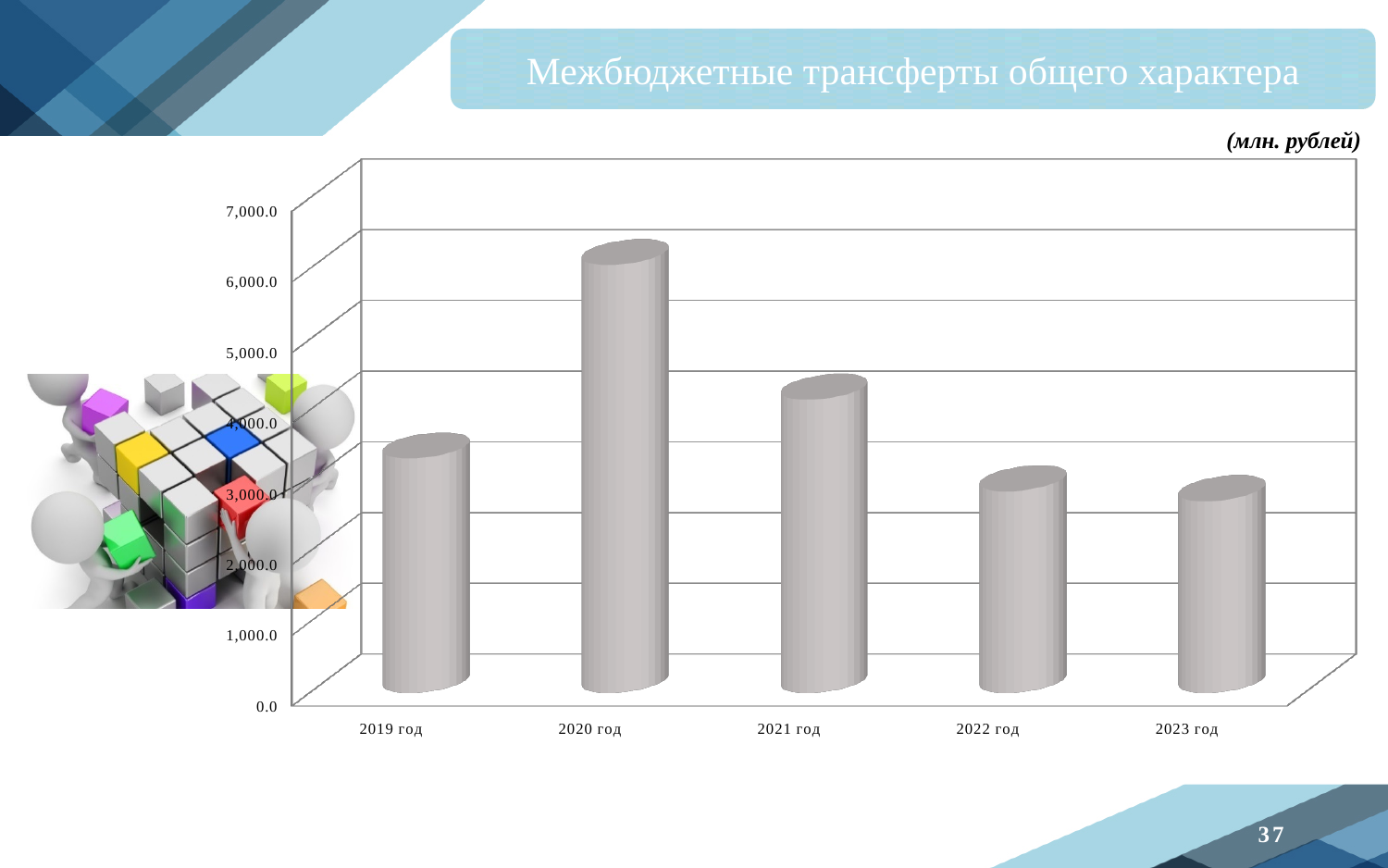
Which is larger, the value for 2020 год or the value for 2021 год? 2020 год Is the value for 2020 год greater or less than 5,000.0? greater Do the values rise or fall from 2020 год to 2023 год? fall Is the value for 2022 год greater or less than 4,000.0? less What kind of chart is shown on the slide? bar chart Is the value for 2019 год greater or less than 5,000.0? less How many years are shown on the x axis of the chart? 5 Which is larger, the value for 2019 год or the value for 2021 год? 2021 год What is the title of the chart on the slide? Межбюджетные трансферты общего характера Which year has the highest value in the chart? 2020 год